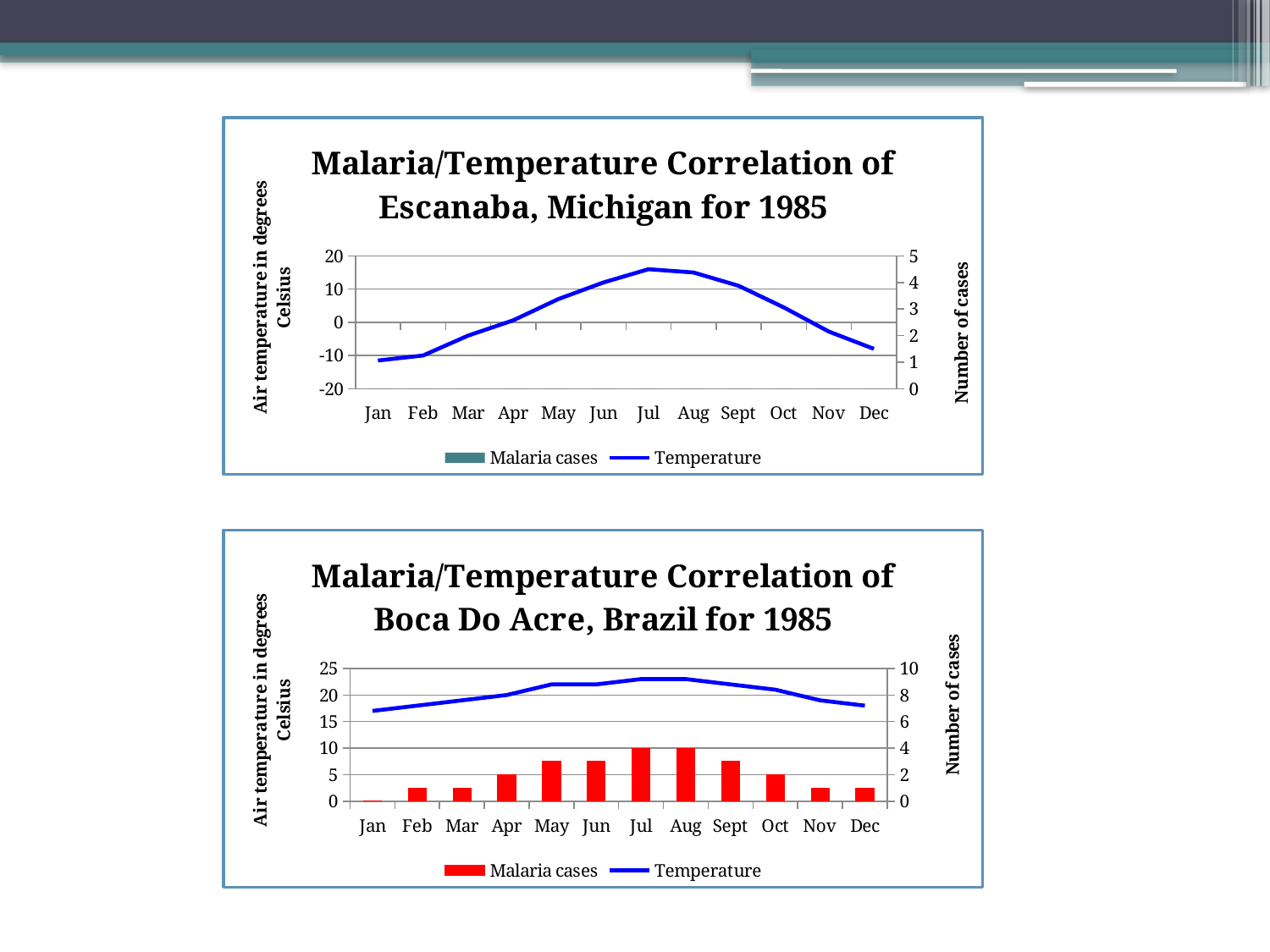
In the top chart (Escanaba, Michigan), which month has the lowest temperature? Jan In the top chart (Escanaba, Michigan), which month has the highest temperature? Jul In the bottom chart (Boca Do Acre, Brazil), is the temperature for Jul greater or less than 20? greater How many series does the legend of the bottom chart (Boca Do Acre, Brazil) list? 2 In the top chart (Escanaba, Michigan), is the temperature for Jul greater or less than 10? greater In the top chart (Escanaba, Michigan), is the temperature for Jan greater or less than 0? less In the bottom chart (Boca Do Acre, Brazil), which month has the lowest number of malaria cases? Jan In the bottom chart (Boca Do Acre, Brazil), which has more malaria cases, Jul or Feb? Jul How many months are shown on the x axis of the top chart (Escanaba, Michigan)? 12 In the top chart (Escanaba, Michigan), does the temperature rise or fall from Jan to Jul? rise What colour are the malaria cases bars in the bottom chart (Boca Do Acre, Brazil)? Red